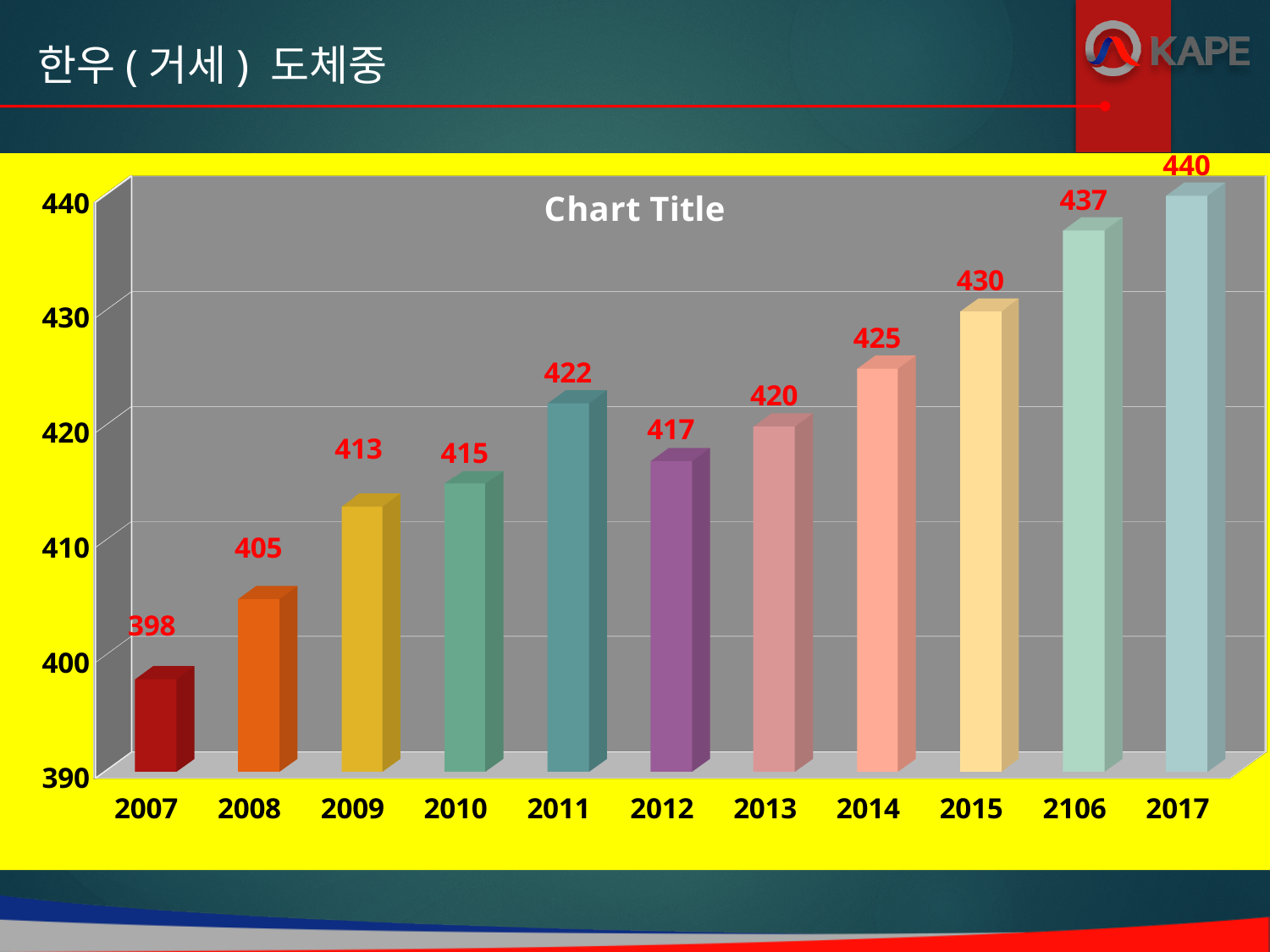
Which year has the highest value? 2017 What is the difference between the values for 2011 and 2012? 5 What is the title printed inside the chart area? Chart Title Is the value for 2014 greater or less than 420? greater What is the value for 2015? 430 What is the value for 2007? 398 How many years are shown on the x axis? 11 Which year has the lowest value? 2007 What is the value for 2012? 417 What is the difference between the values for 2017 and 2007? 42 What kind of chart is shown on the slide? bar chart Which is larger, the value for 2011 or the value for 2013? 2011